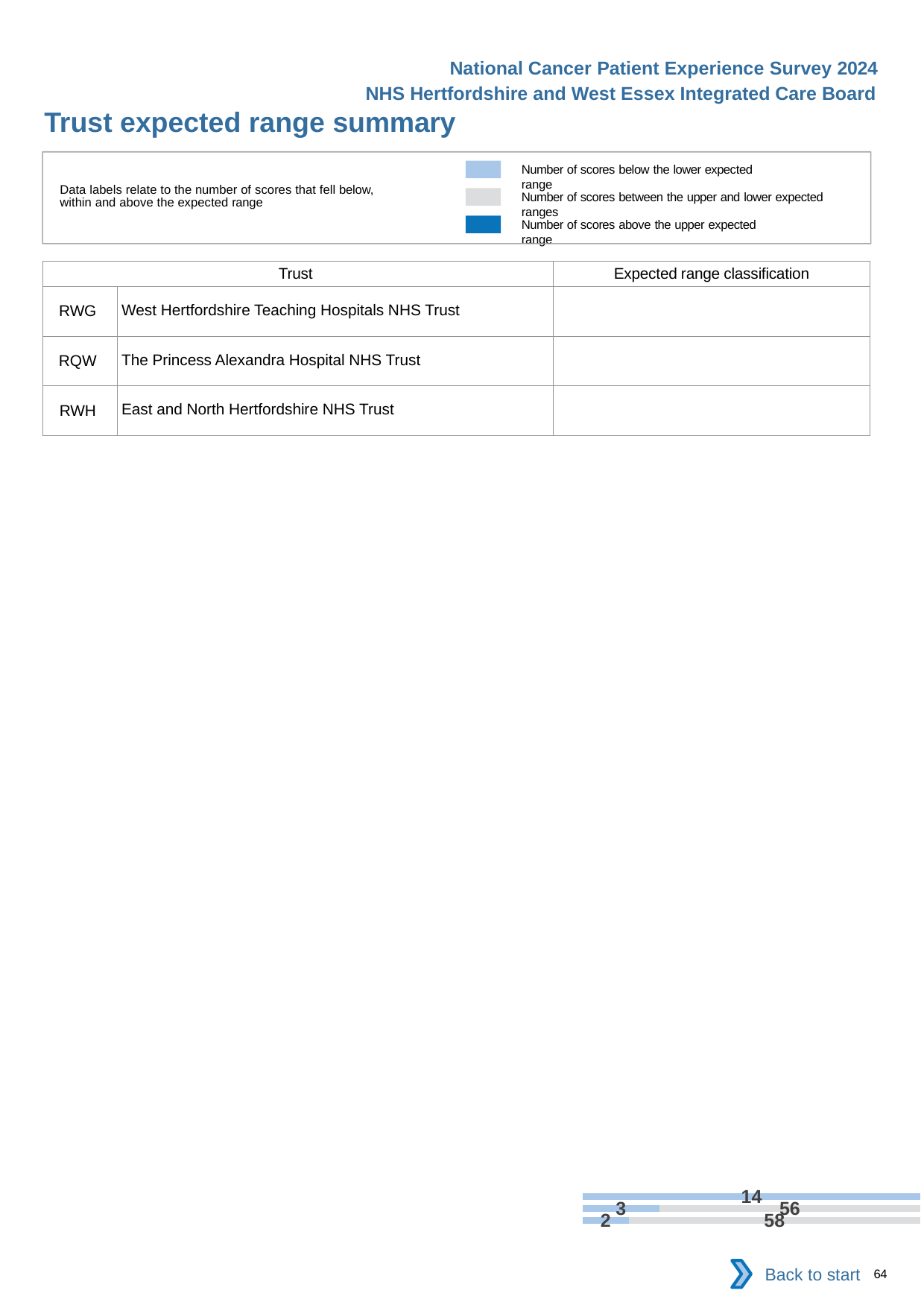
What is the largest data label printed on the bar chart at the bottom right of the slide? 58 What kind of chart is shown at the bottom right of the slide? bar chart According to the legend, what does the light blue colour represent? Number of scores below the lower expected range On the bar chart at the bottom right, what is the difference between the data labels 58 and 56? 2 What is the smallest data label printed on the bar chart at the bottom right of the slide? 2 How many categories does the legend at the top of the slide list? 3 On the bar chart at the bottom right, which is larger, the data label 56 or the data label 58? 58 According to the legend, what does the dark blue colour represent? Number of scores above the upper expected range